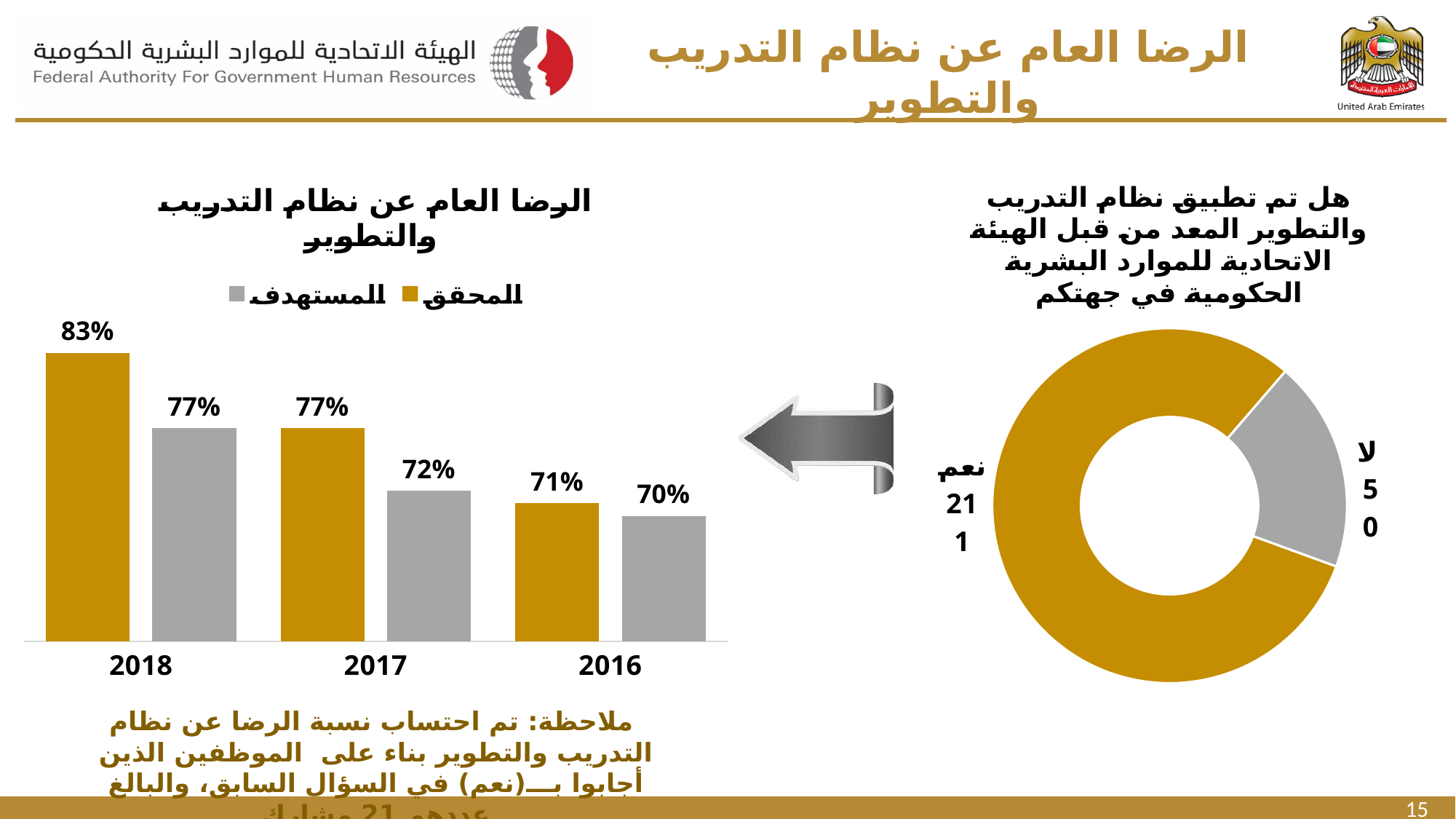
In the bar chart on the left, which year has the highest المحقق value? 2018 In the bar chart on the left, do the المحقق values rise or fall from 2016 to 2018? rise In the bar chart on the left, is المحقق for 2017 larger or smaller than المستهدف for 2017? larger In the bar chart on the left, what is the value of المستهدف for 2017? 72% How many years are shown on the x axis of the bar chart on the left? 3 In the bar chart on the left, what is the value of المحقق for 2016? 71% In the bar chart on the left, what is the value of المحقق for 2018? 83% In the donut chart on the right, how many respondents answered نعم? 21 In the bar chart on the left, which year has the lowest المستهدف value? 2016 How many series does the legend of the bar chart on the left list? 2 In the donut chart on the right, what is the total of the نعم and لا values? 26 In the bar chart on the left, what is the difference between المحقق and المستهدف for 2018? 6%